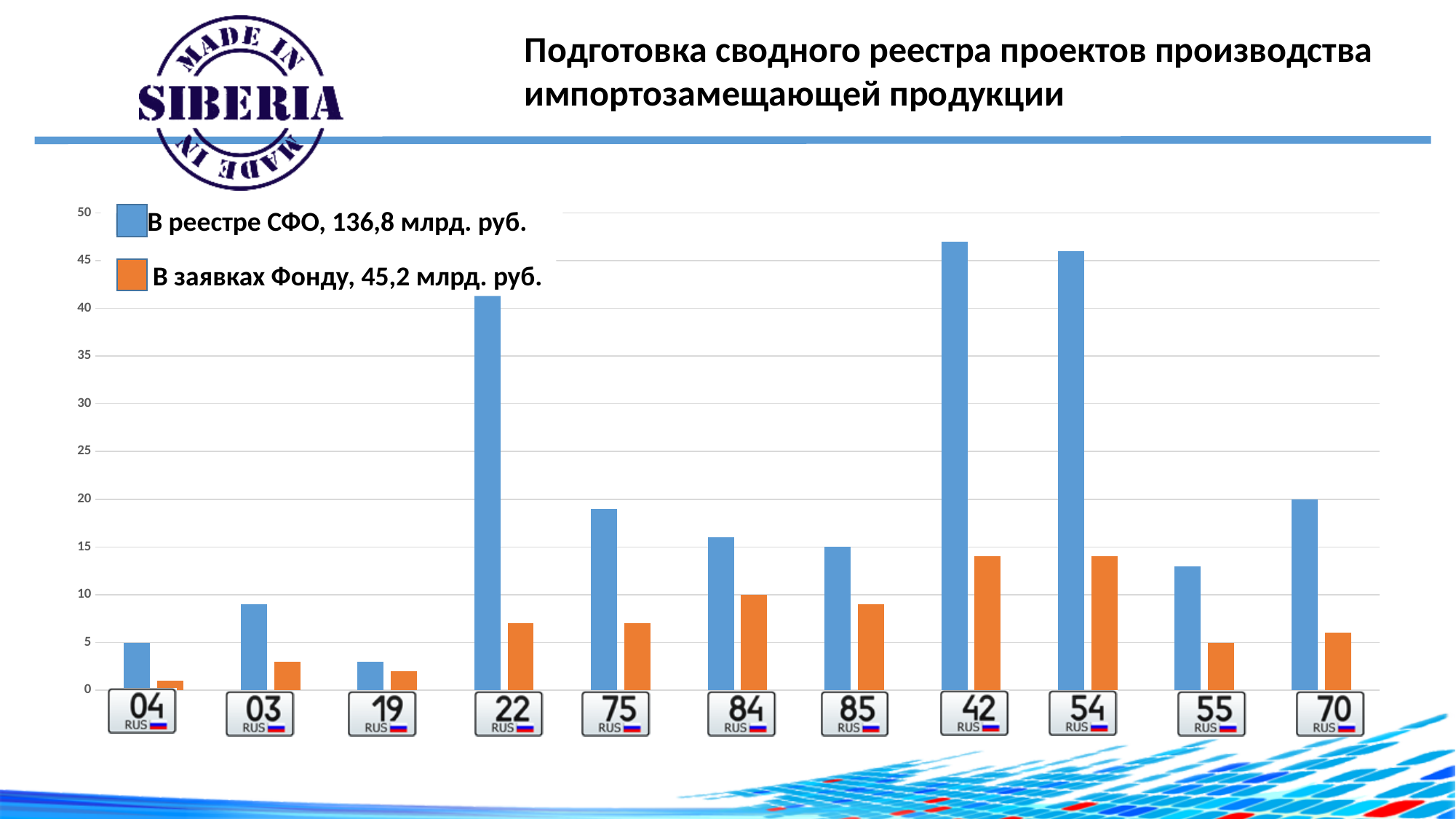
Is the orange 'В заявках Фонду' value for region 42 greater or less than 15? less How many region categories are shown along the x axis? 11 What is the value of the blue 'В реестре СФО' bar for region 70? 20 What is the value of the orange 'В заявках Фонду' bar for region 84? 10 How many series does the legend list? 2 Which is larger: the blue 'В реестре СФО' bar for region 22 or for region 75? 22 What is the value of the blue 'В реестре СФО' bar for region 04? 5 Which region has the lowest blue 'В реестре СФО' bar? 19 Is the blue 'В реестре СФО' value for region 22 greater or less than 40? greater What total amount does the legend give for the 'В реестре СФО' series? 136,8 млрд. руб. What kind of chart is shown on the slide? bar chart Which region has the lowest orange 'В заявках Фонду' bar? 04